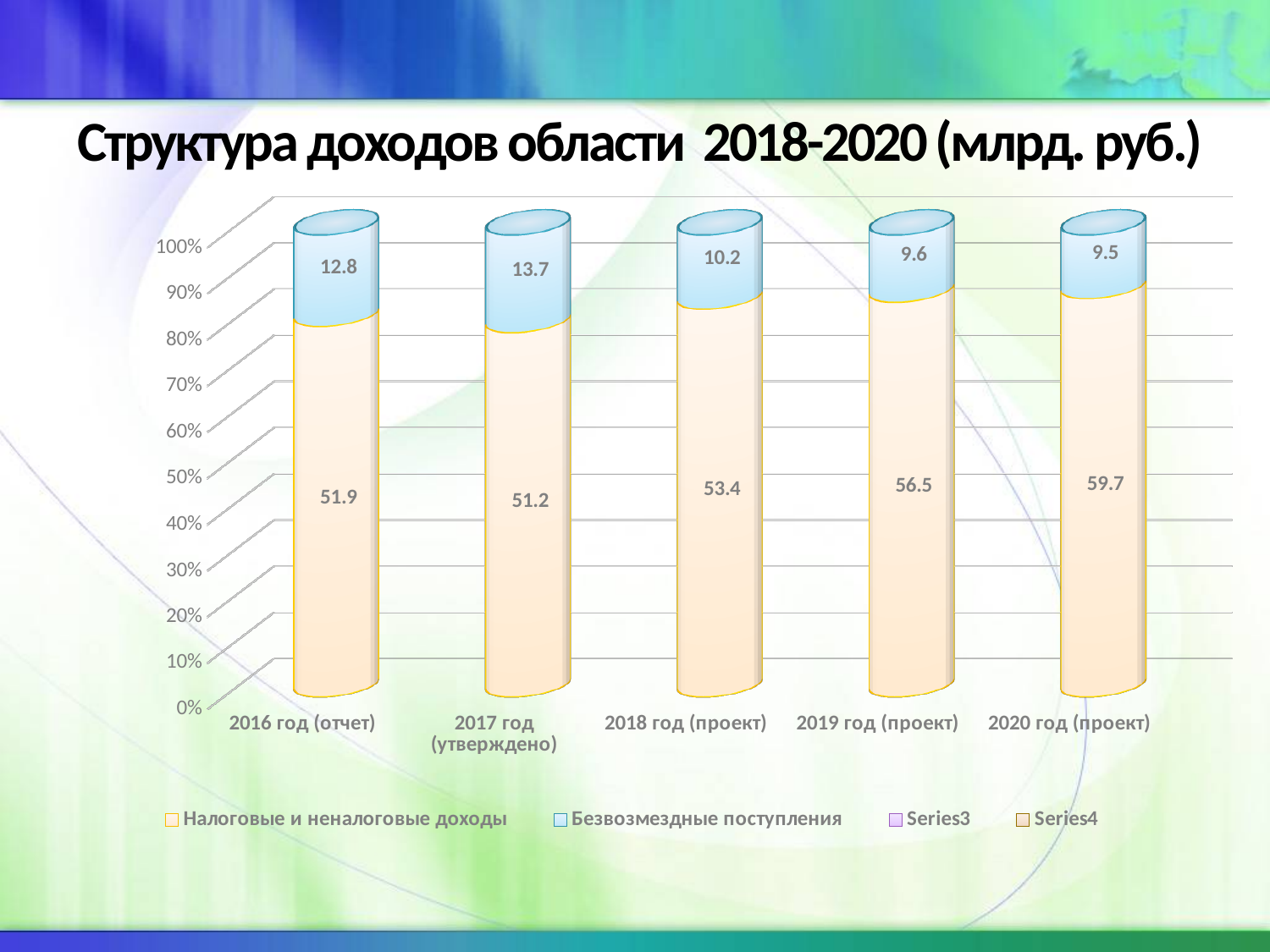
Which is larger: Безвозмездные поступления for 2016 год (отчет) or for 2018 год (проект)? 2016 год (отчет) What is the value of Налоговые и неналоговые доходы for 2016 год (отчет)? 51.9 Do the values for Налоговые и неналоговые доходы rise or fall from 2018 год (проект) to 2020 год (проект)? Rise What is the value of Налоговые и неналоговые доходы for 2020 год (проект)? 59.7 What is the difference between Налоговые и неналоговые доходы for 2020 год (проект) and 2016 год (отчет)? 7.8 Which year has the highest value for Налоговые и неналоговые доходы? 2020 год (проект) How many years are shown on the x axis? 5 What is the total of the two labelled values for 2019 год (проект)? 66.1 What is the value of Безвозмездные поступления for 2017 год (утверждено)? 13.7 What kind of chart is shown on the slide? Stacked bar chart Which year has the lowest value for Безвозмездные поступления? 2020 год (проект) How many series does the legend list? 4